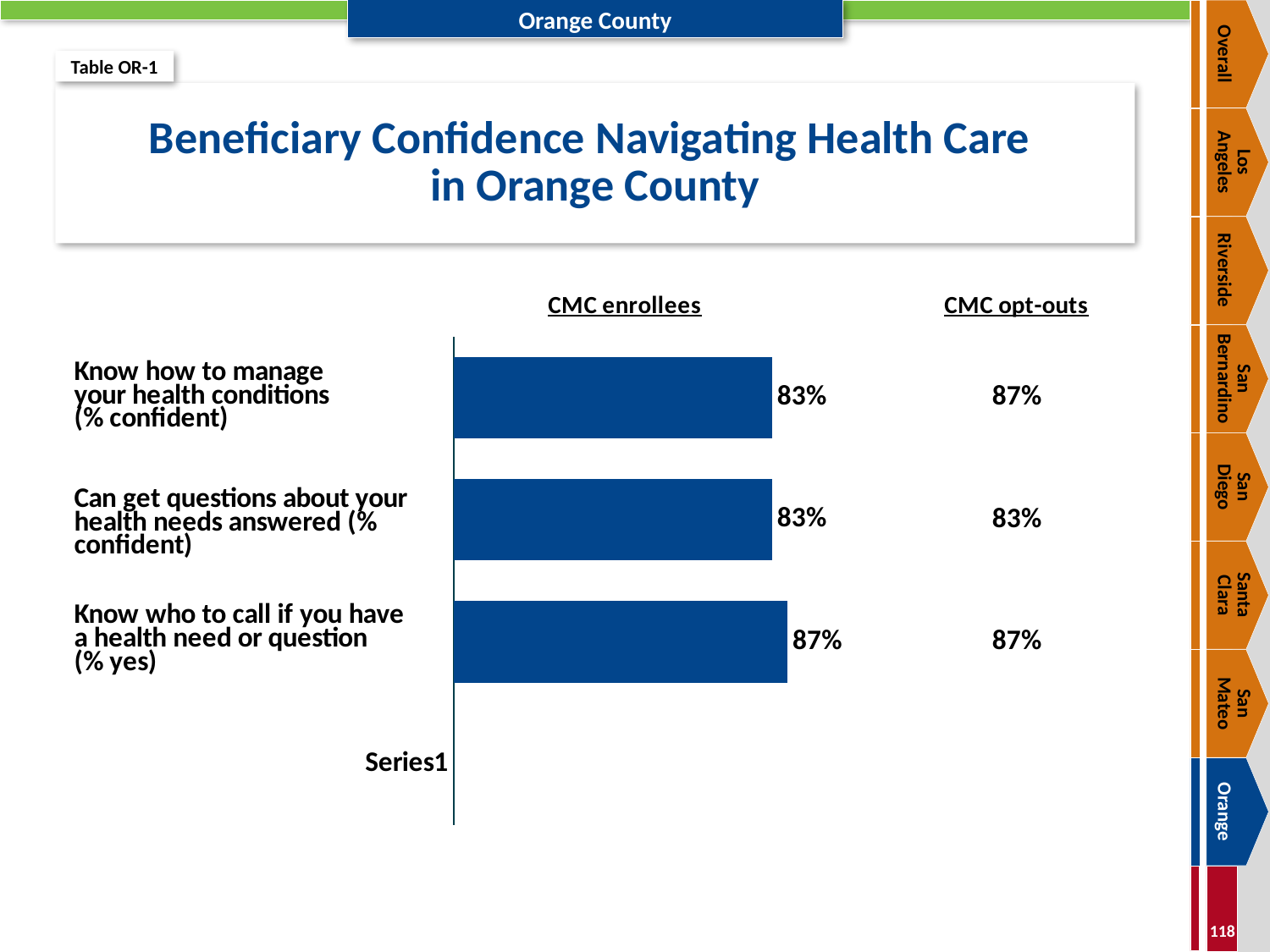
What are the two column headings shown above the values? CMC enrollees and CMC opt-outs What is the difference between the CMC enrollees values for "Know who to call if you have a health need or question (% yes)" and "Can get questions about your health needs answered (% confident)"? 4% What is the difference between the CMC opt-outs and CMC enrollees values for "Know how to manage your health conditions (% confident)"? 4% What is the CMC opt-outs value for "Know how to manage your health conditions (% confident)"? 87% What is the title of the chart? Beneficiary Confidence Navigating Health Care in Orange County What is the CMC enrollees value for "Know who to call if you have a health need or question (% yes)"? 87% What is the CMC enrollees value for "Know how to manage your health conditions (% confident)"? 83% Which item has the highest CMC enrollees value? Know who to call if you have a health need or question (% yes) How many items have bars plotted in the chart? 3 What is the CMC opt-outs value for "Can get questions about your health needs answered (% confident)"? 83% For "Know how to manage your health conditions (% confident)", which group has the larger value, CMC enrollees or CMC opt-outs? CMC opt-outs What kind of chart is shown on the slide? bar chart